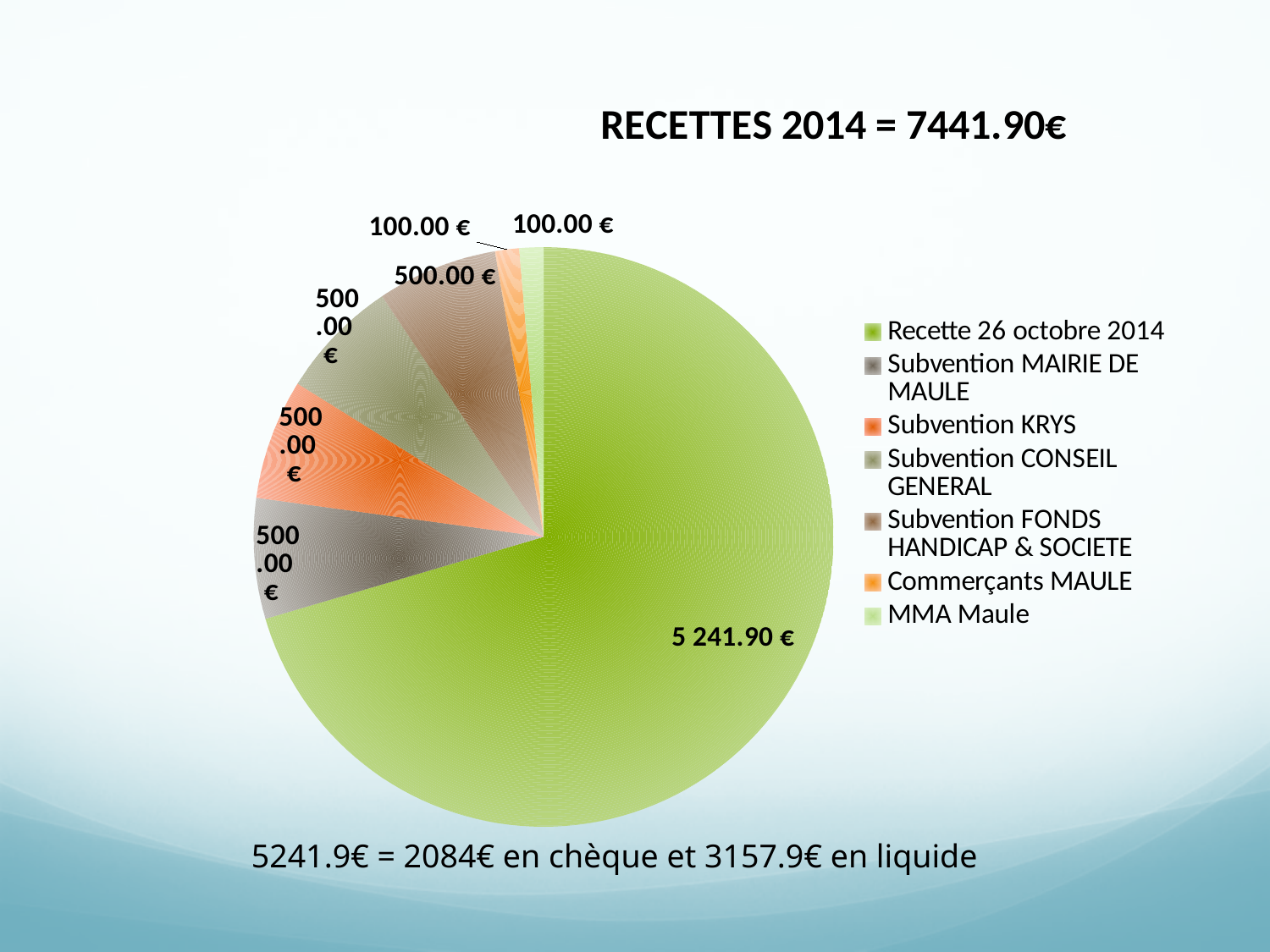
Which is larger, the Subvention CONSEIL GENERAL slice or the MMA Maule slice? Subvention CONSEIL GENERAL What is the total of all the slices, as given in the chart title? 7441.90€ What kind of chart is shown on the slide? pie chart What is the value of the Recette 26 octobre 2014 slice? 5 241.90 € What is the title of the chart? RECETTES 2014 = 7441.90€ Which category has the largest slice of the pie? Recette 26 octobre 2014 What is the value of the MMA Maule slice? 100.00 € What is the difference between the Recette 26 octobre 2014 slice and the Subvention MAIRIE DE MAULE slice? 4 741.90 € What is the value of the Subvention KRYS slice? 500.00 € What is the value of the Commerçants MAULE slice? 100.00 € How many categories does the pie chart have? 7 What is the difference between the Subvention KRYS slice and the Commerçants MAULE slice? 400.00 €